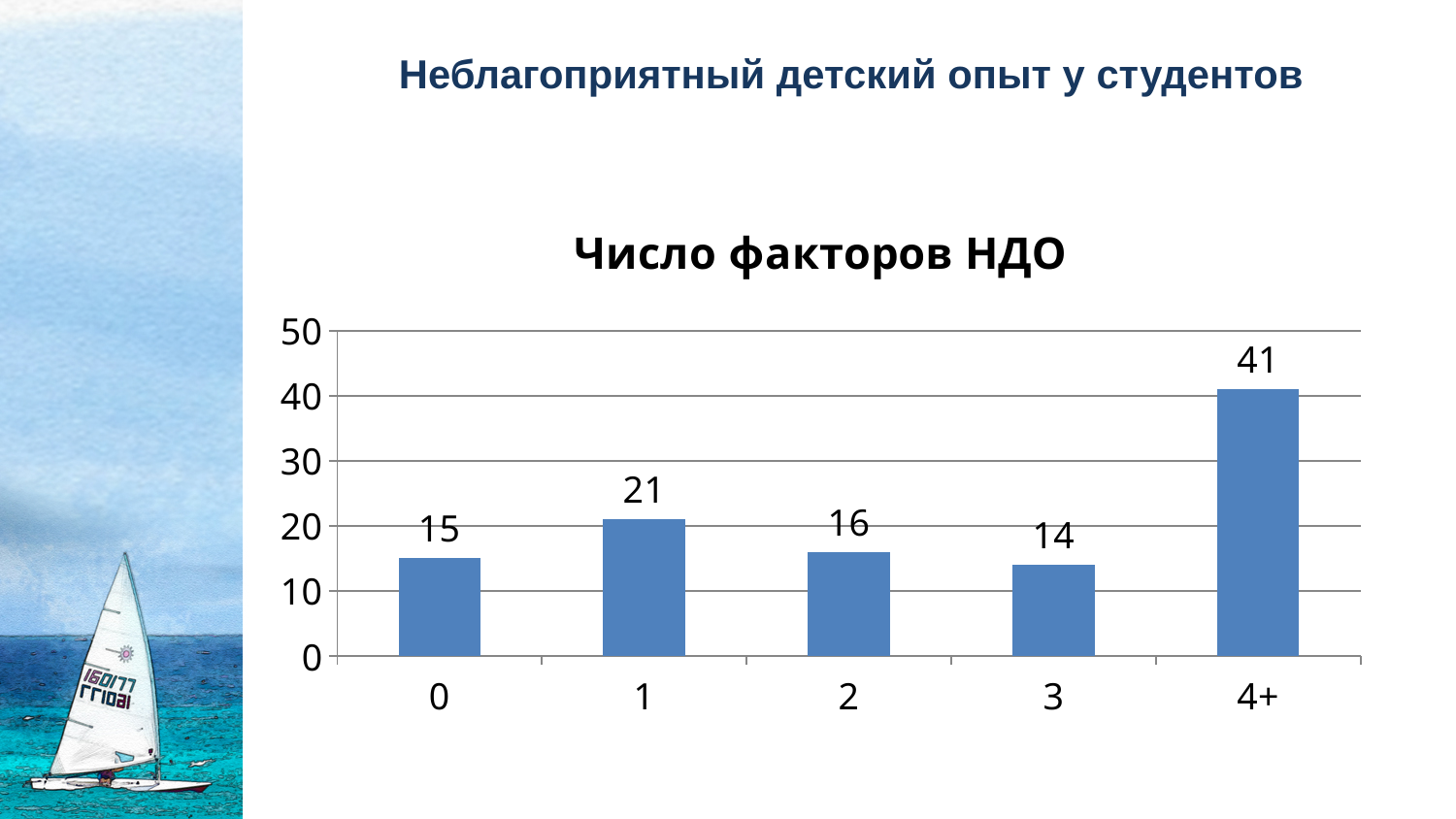
What is the difference between the values for "1" and "3"? 7 What is the value for category "4+"? 41 What is the difference between the values for "4+" and "1"? 20 What is the value for category "2"? 16 How many categories are shown on the x axis? 5 What kind of chart is shown on the slide? bar chart Which is larger, the value for "1" or the value for "2"? 1 What is the value for category "0"? 15 Which category has the highest value? 4+ Is the value for "4+" greater or less than 40? greater Which category has the lowest value? 3 What is the title of the chart? Число факторов НДО